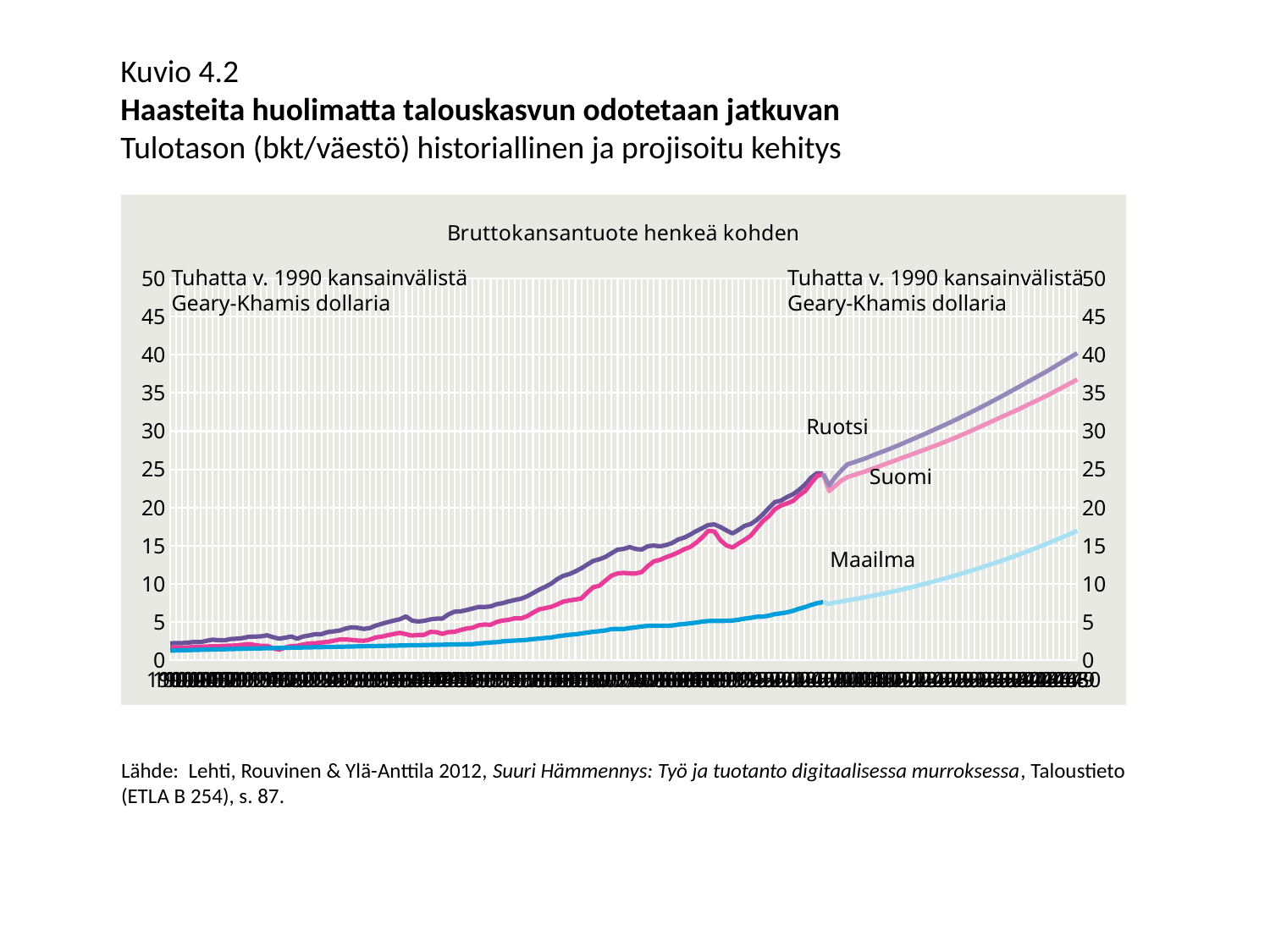
What is the title shown inside the chart area? Bruttokansantuote henkeä kohden At the right end of the chart, which is larger, the value for Suomi or the value for Maailma? Suomi At the right end of the chart, is the value for Maailma greater or less than 20? less Which series has the lowest values across the chart? Maailma Do the values for Maailma rise or fall along the x axis overall? rise At the right end of the chart, is the value for Suomi greater or less than 30? greater What kind of chart is shown on the slide? line chart What is the highest value shown on the y axis? 50 At the right end of the chart, is the value for Ruotsi greater or less than 35? greater How many series are plotted in the chart? 3 Which series reaches the highest value at the right end of the chart? Ruotsi